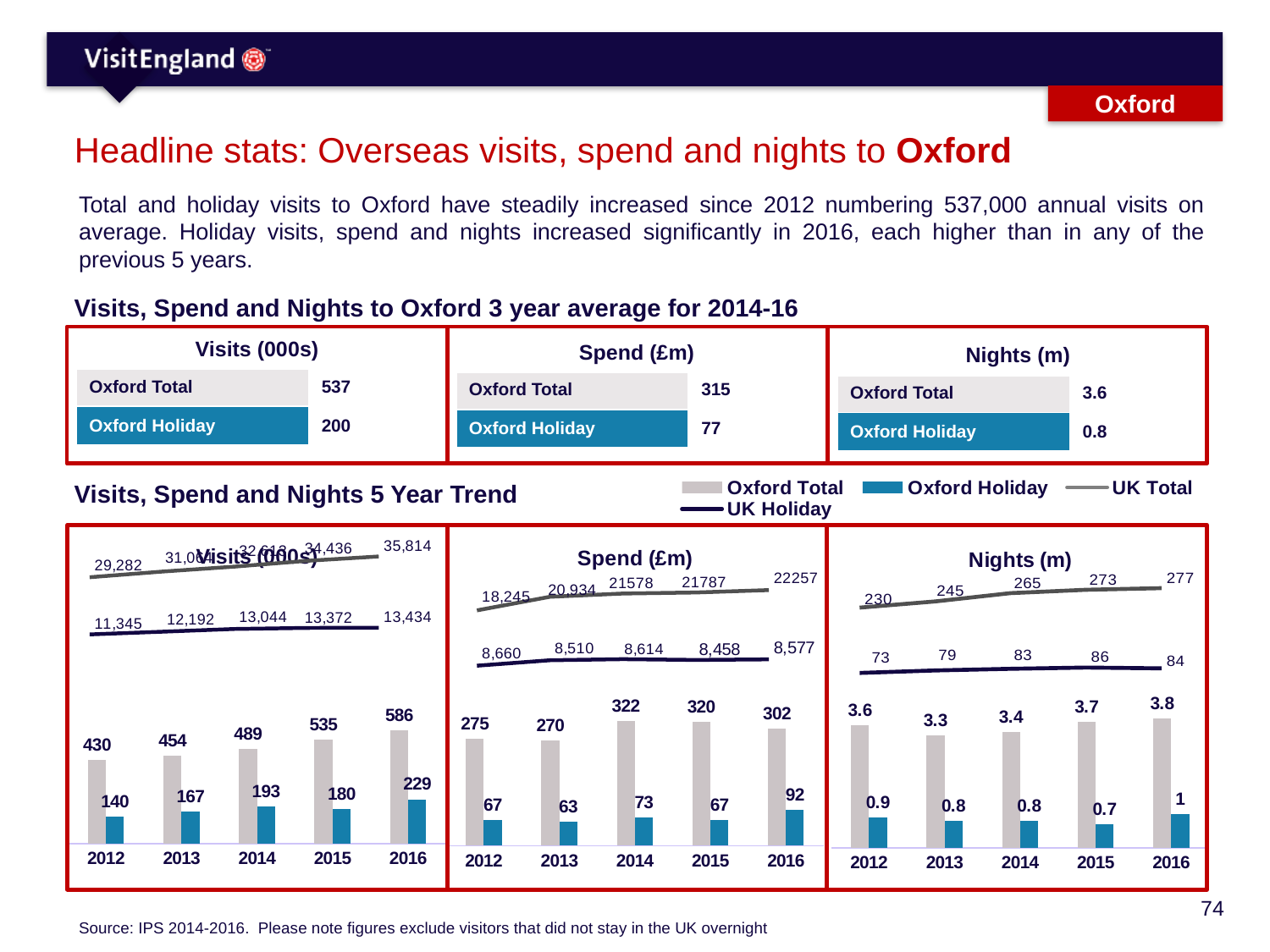
How many series does the legend for the 5 Year Trend charts list? 4 How many years are shown on the x axis of the Spend (£m) chart? 5 In the Visits (000s) chart, what is the Oxford Holiday value for 2014? 193 In the Nights (m) chart, what is the difference between the Oxford Total values for 2016 and 2013? 0.5 In the Spend (£m) chart, which year has the lowest Oxford Holiday value? 2013 In the Spend (£m) chart, which year has the highest Oxford Total value? 2014 In the Visits (000s) chart, what is the Oxford Total value for 2016? 586 In the Nights (m) chart, what is the UK Total value for 2014? 265 In the Spend (£m) chart, what is the UK Holiday value for 2015? 8,458 What kind of chart is used for the Oxford Total and Oxford Holiday series in the Nights (m) chart? Bar chart In the Visits (000s) chart, do the Oxford Total values rise or fall from 2012 to 2016? Rise In the Visits (000s) chart, is the Oxford Holiday value larger in 2015 or in 2016? 2016